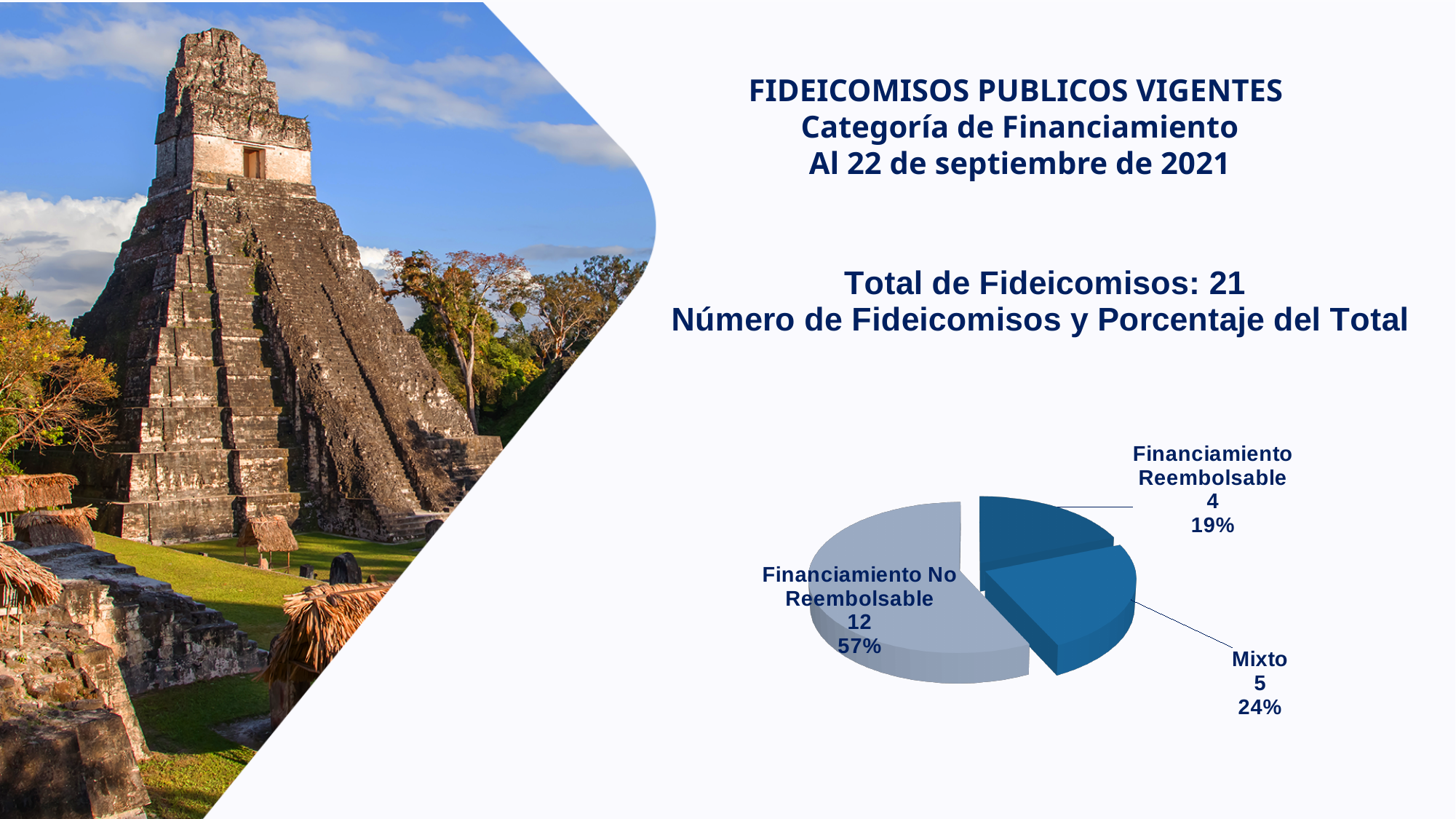
How many fideicomisos are in the Financiamiento Reembolsable category? 4 Which category has the largest number of fideicomisos? Financiamiento No Reembolsable What kind of chart is shown on the slide? Pie chart How many categories does the pie chart show? 3 How many fideicomisos are in the Financiamiento No Reembolsable category? 12 What percentage of the total does Financiamiento No Reembolsable represent? 57% What percentage of the total does Mixto represent? 24% What percentage of the total does Financiamiento Reembolsable represent? 19% What is the difference in the number of fideicomisos between Financiamiento No Reembolsable and Mixto? 7 What is the total number of fideicomisos stated on the slide? 21 Which category has the smallest number of fideicomisos? Financiamiento Reembolsable How many fideicomisos are in the Mixto category? 5